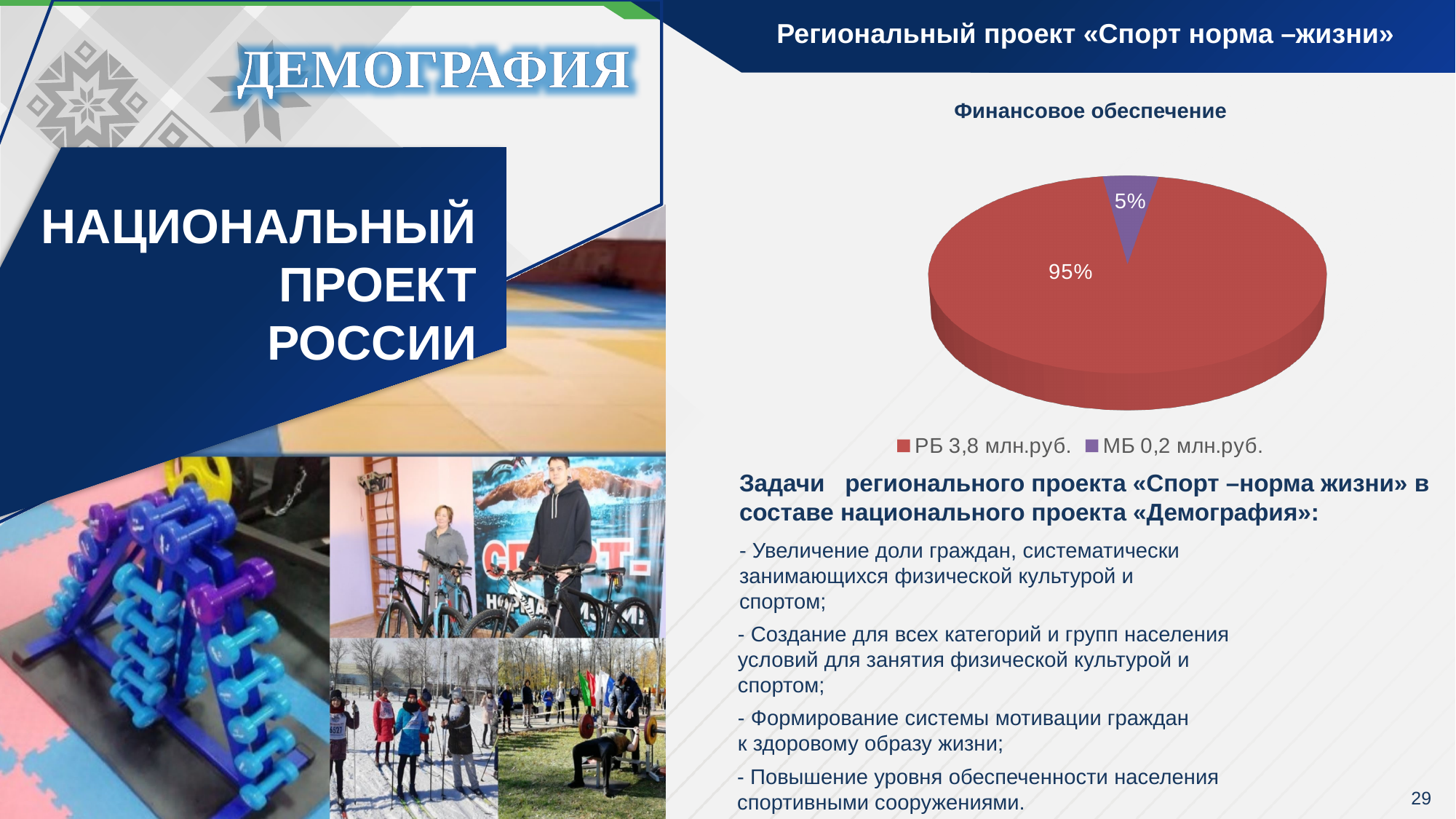
How many entries does the legend of the pie chart list? 2 What is the difference in percentage points between the РБ share and the МБ share? 90% What colour is the slice for «МБ 0,2 млн.руб.» in the pie chart? purple What kind of chart is shown under the title «Финансовое обеспечение»? pie chart What share of the pie does «РБ 3,8 млн.руб.» take? 95% What is the title of the chart on the slide? Финансовое обеспечение Which slice of the pie chart is the largest? РБ 3,8 млн.руб. What amount in млн.руб. is listed in the legend for РБ? 3,8 млн.руб. Which is larger in the pie chart: the share for РБ or the share for МБ? РБ Which slice of the pie chart is the smallest? МБ 0,2 млн.руб. How many slices does the pie chart have? 2 What share of the pie does «МБ 0,2 млн.руб.» take? 5%